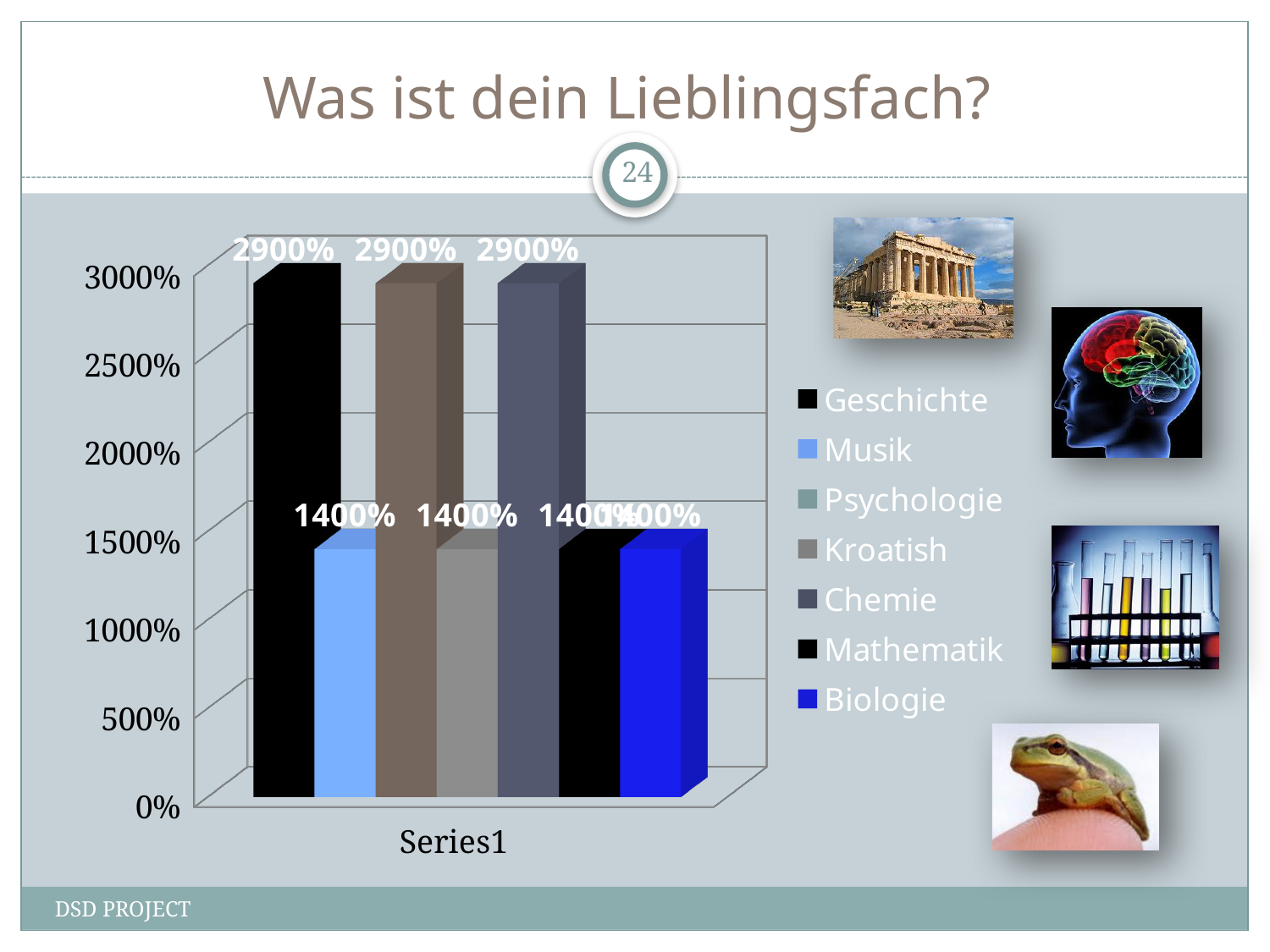
How many entries does the chart legend list? 7 What is the value shown for Chemie? 2900% Is the value for Musik greater or less than 2000%? less What is the difference between the values for Geschichte and Musik? 1500% What is the title of the chart on the slide? Was ist dein Lieblingsfach? What is the value shown for Geschichte? 2900% Which has the larger value, Geschichte or Mathematik? Geschichte What is the value shown for Musik? 1400% What is the value shown for Biologie? 1400% What kind of chart is shown on the slide? bar chart How many bars in the chart are labelled 2900%? 3 How many bars are plotted in the chart? 7